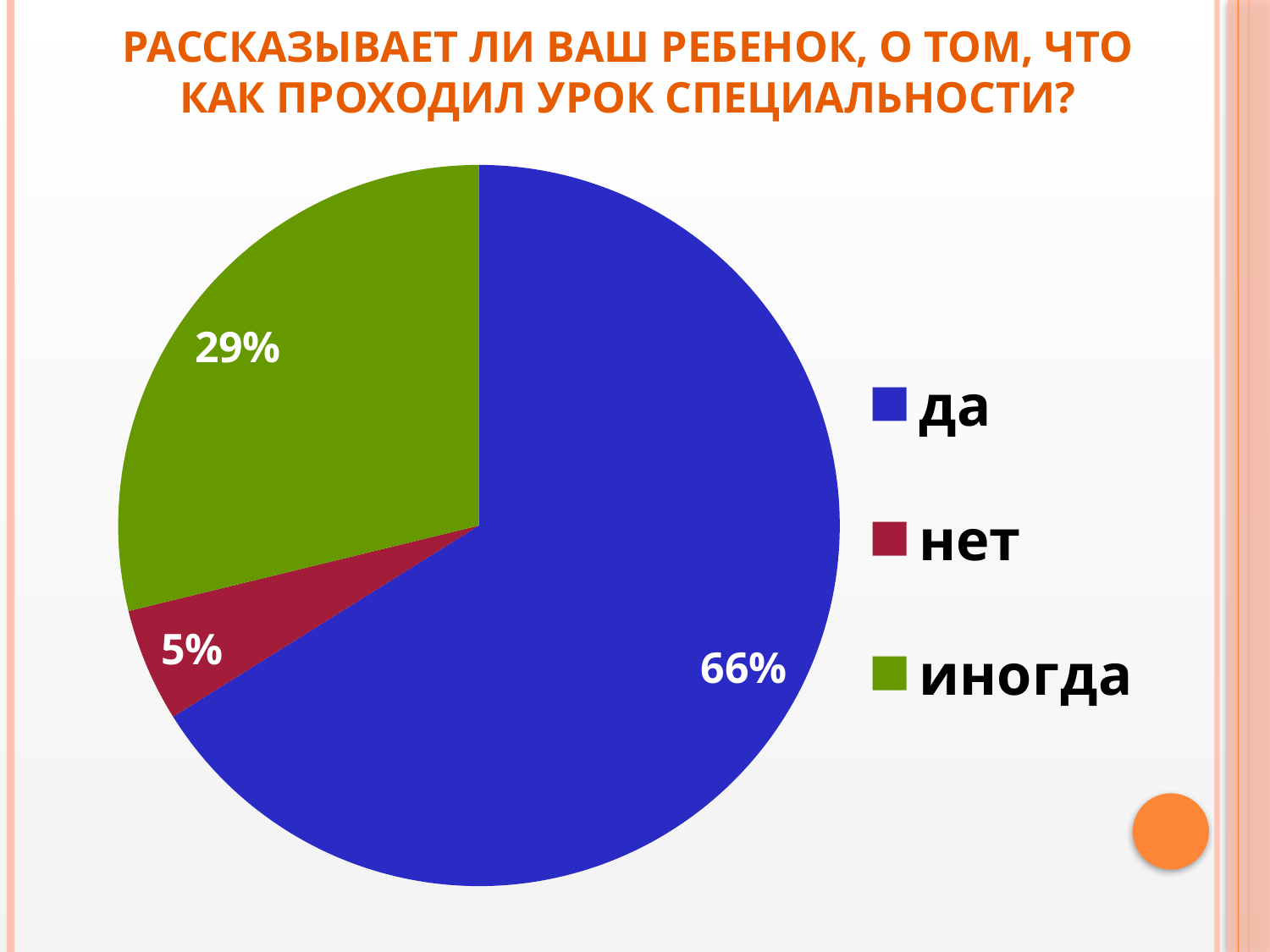
What percentage is shown for "иногда"? 29% How many categories does the pie chart have? 3 What colour is the slice for "иногда"? green What percentage is shown for "да"? 66% What is the difference in percentage points between "иногда" and "нет"? 24 Which is larger, the share for "иногда" or the share for "нет"? иногда Which category has the smallest share of the pie? нет What is the difference in percentage points between "да" and "иногда"? 37 What colour is the slice for "да"? blue What kind of chart is shown on the slide? pie chart What percentage is shown for "нет"? 5% Which category has the largest share of the pie? да